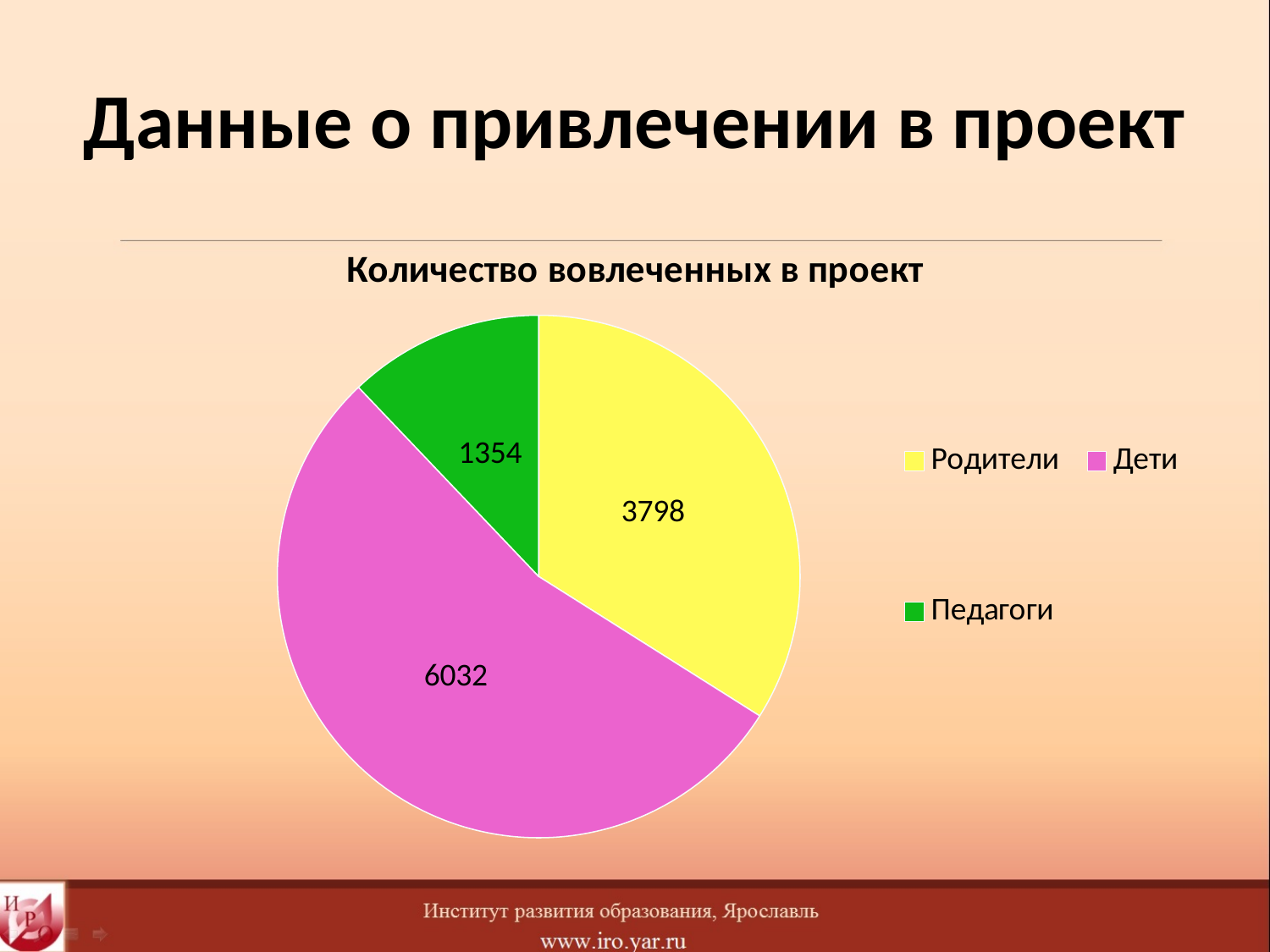
Which category has the smallest slice? Педагоги What is the difference between the values for Родители and Педагоги? 2444 What is the title of the chart? Количество вовлеченных в проект What is the value for Родители? 3798 Which category has the largest slice? Дети What is the total of all slices in the pie chart? 11184 What is the value for Дети? 6032 How many categories does the pie chart have? 3 Which is larger, the value for Родители or the value for Педагоги? Родители What type of chart is shown on the slide? Pie chart What is the value for Педагоги? 1354 What is the difference between the values for Дети and Родители? 2234